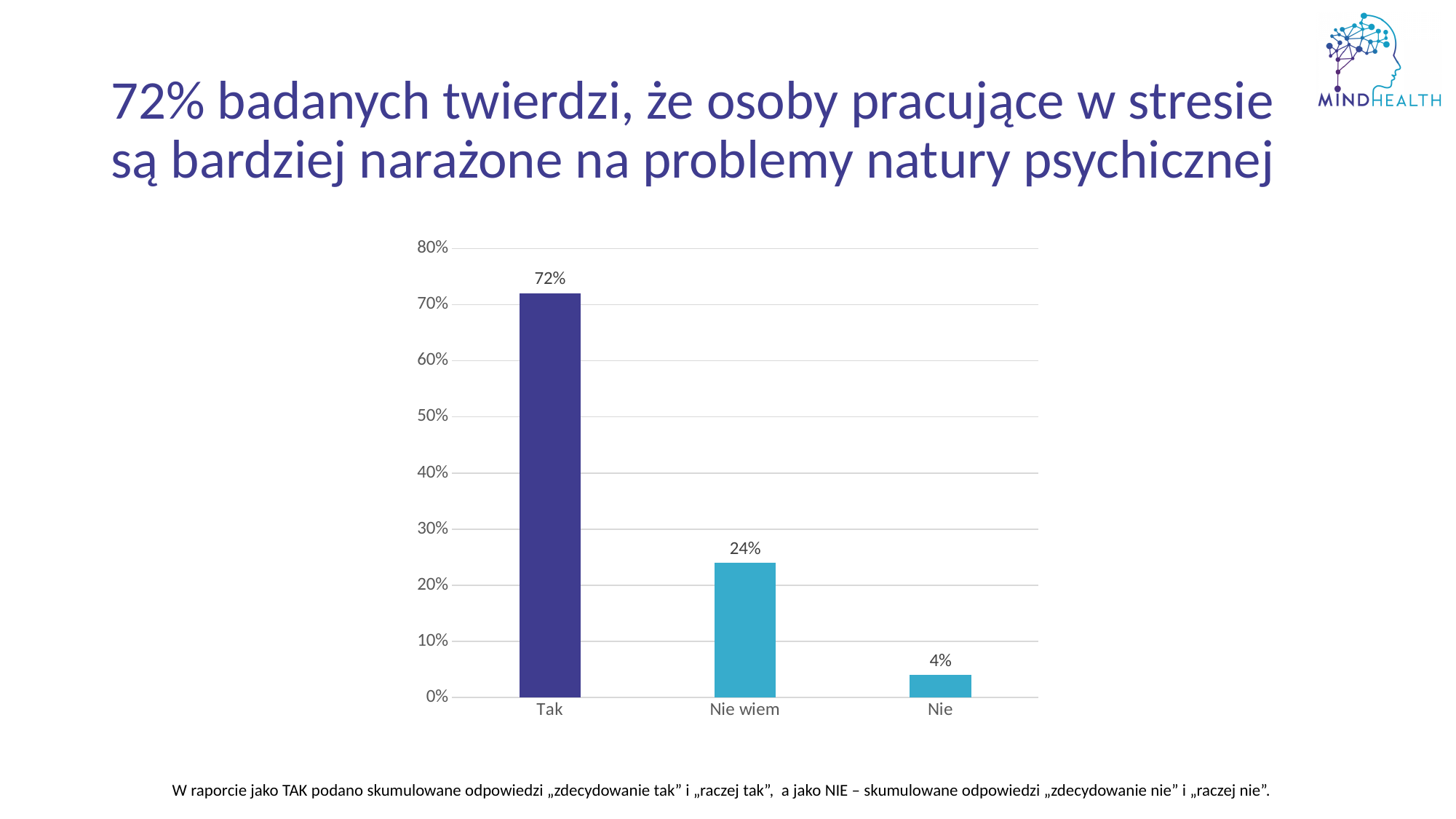
What kind of chart is shown on the slide? bar chart Is the value for Tak greater or less than 50%? greater What is the difference between the values for Tak and Nie wiem? 48% What is the difference between the values for Nie wiem and Nie? 20% Which category has the highest value? Tak How many categories are shown on the x axis? 3 Which is larger, the value for Nie wiem or the value for Nie? Nie wiem Do the values rise or fall from left to right along the x axis? fall What is the value for Tak? 72% Which category has the lowest value? Nie What is the value for Nie wiem? 24% What is the value for Nie? 4%